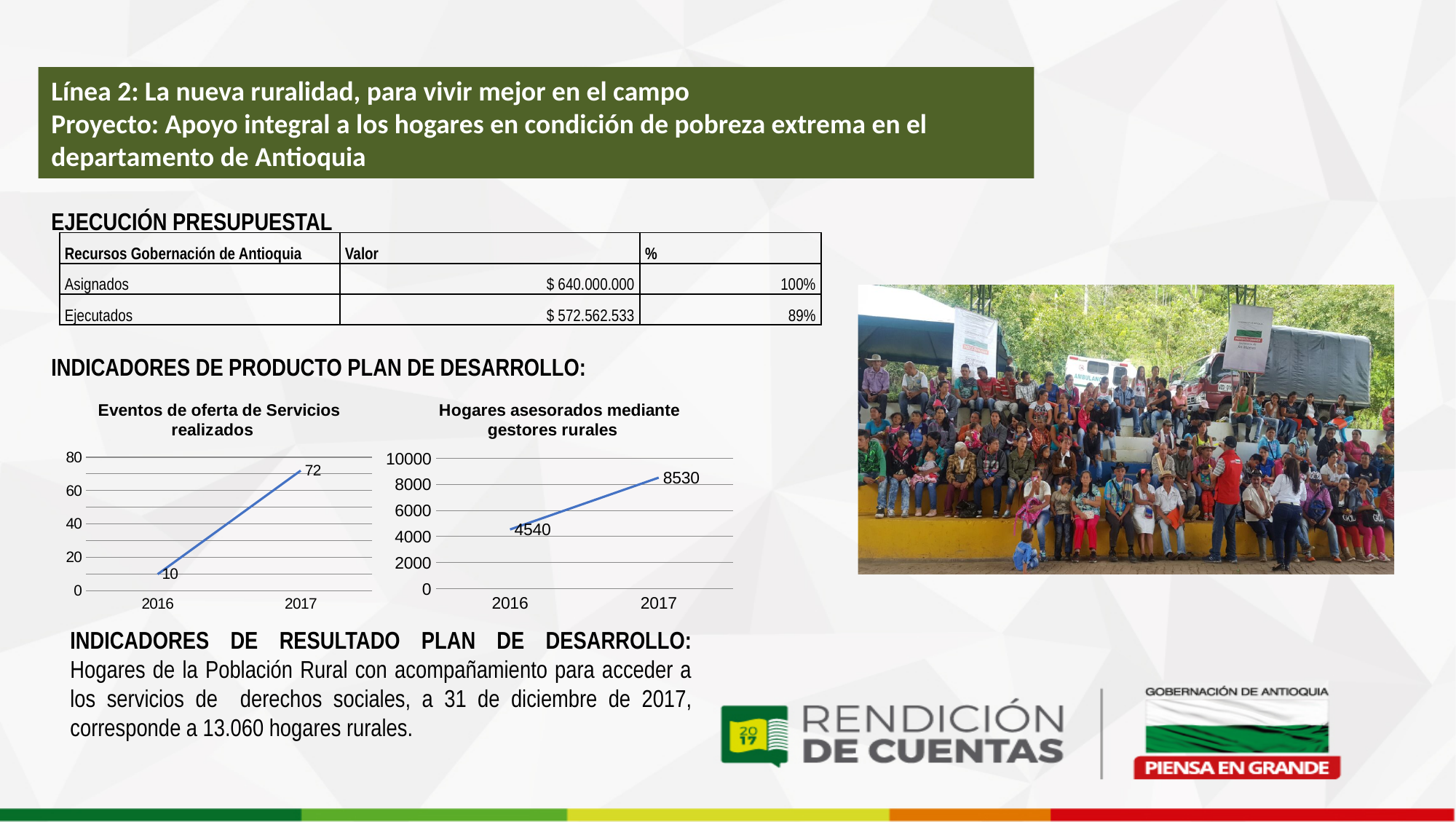
In the 'Hogares asesorados mediante gestores rurales' chart, what is the value for 2017? 8530 In the 'Eventos de oferta de Servicios realizados' chart, do the values rise or fall from 2016 to 2017? rise In the 'Eventos de oferta de Servicios realizados' chart, what is the difference between the 2017 and 2016 values? 62 In the 'Hogares asesorados mediante gestores rurales' chart, what is the value for 2016? 4540 In the 'Hogares asesorados mediante gestores rurales' chart, what is the difference between the 2017 and 2016 values? 3990 In the 'Hogares asesorados mediante gestores rurales' chart, is the value for 2016 greater or less than 4000? greater In the 'Eventos de oferta de Servicios realizados' chart, which year has the lowest value? 2016 In the 'Hogares asesorados mediante gestores rurales' chart, which year has the higher value? 2017 In the 'Eventos de oferta de Servicios realizados' chart, what is the value for 2017? 72 What kind of chart is 'Hogares asesorados mediante gestores rurales'? line chart How many data points are plotted in the 'Hogares asesorados mediante gestores rurales' chart? 2 In the 'Eventos de oferta de Servicios realizados' chart, what is the value for 2016? 10